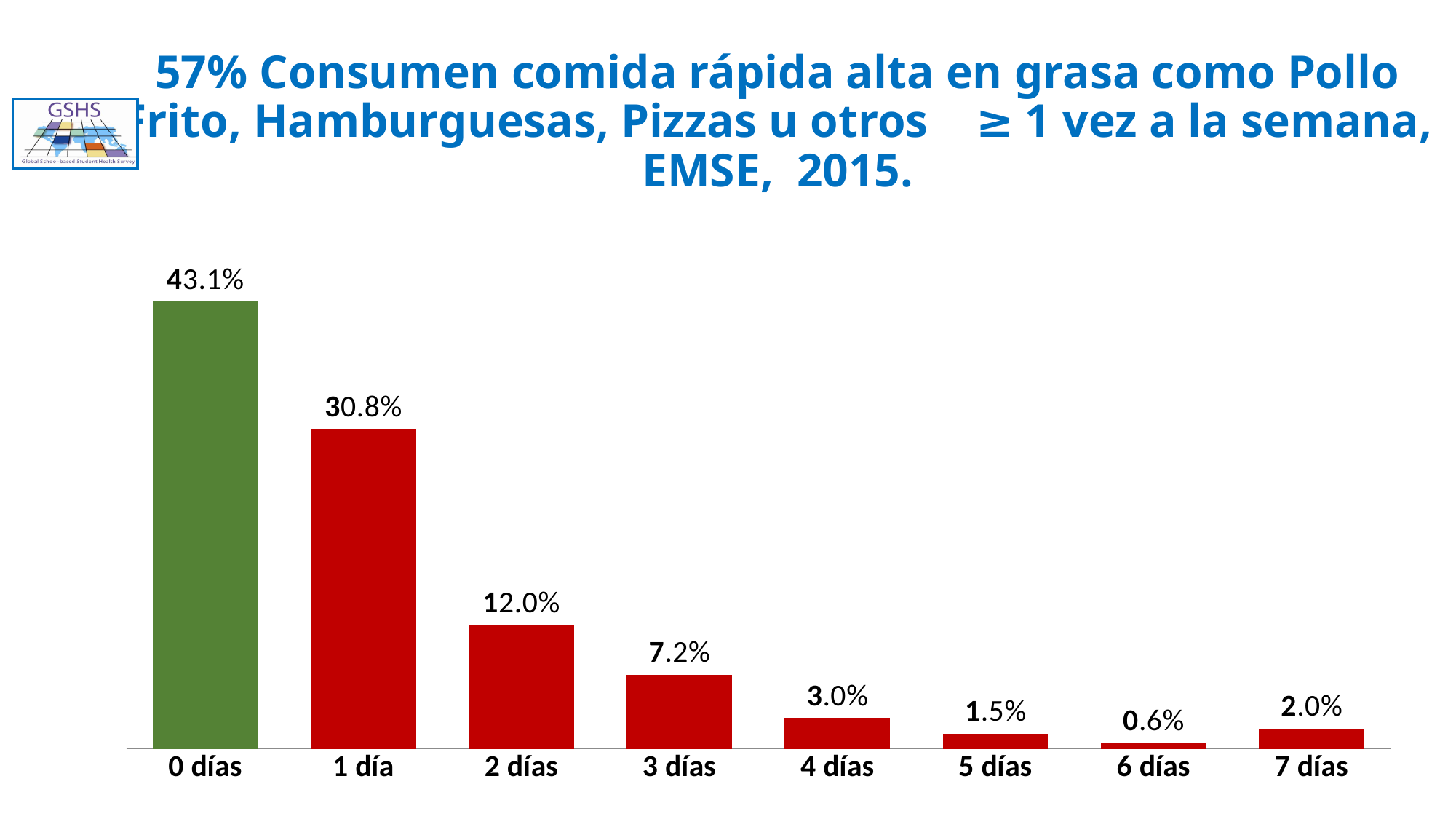
Which bar is coloured green rather than red? 0 días What is the value for 6 días? 0.6% Which is larger, the value for 5 días or the value for 7 días? 7 días What is the value for 1 día? 30.8% How many categories are shown on the x axis? 8 What is the difference between the values for 2 días and 3 días? 4.8% What kind of chart is shown on the slide? Bar chart Which category has the highest value? 0 días Which category has the lowest value? 6 días What is the value for 0 días? 43.1% What is the value for 3 días? 7.2% What is the difference between the values for 0 días and 1 día? 12.3%